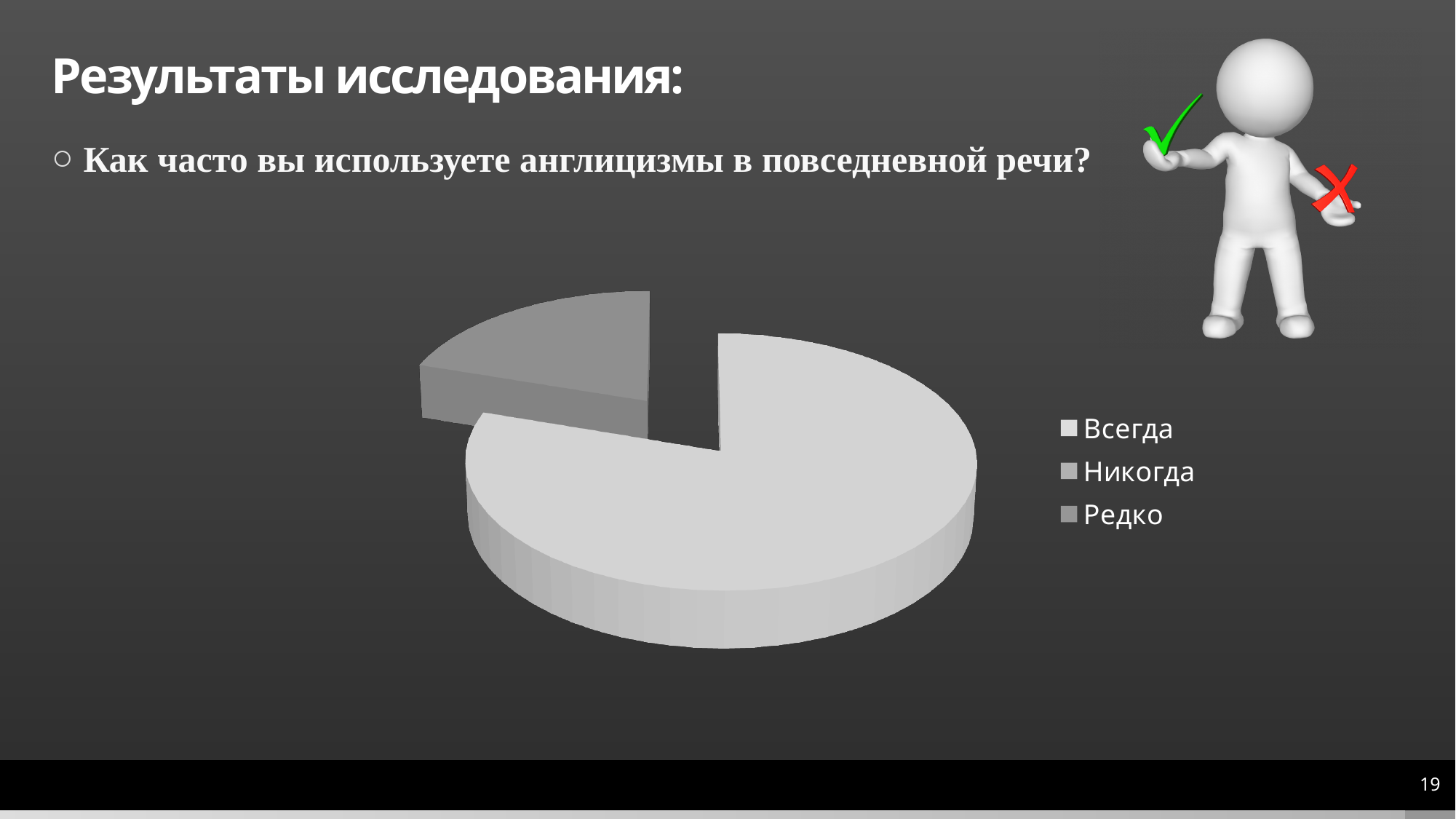
Which slice is larger, Всегда or Редко? Всегда Does the Всегда slice take up more or less than half of the pie? more Which category has the largest slice of the pie? Всегда What are the three legend entries of the chart? Всегда, Никогда, Редко How many entries does the chart legend list? 3 What kind of chart is shown on the slide? pie chart Which category is shown as the exploded (pulled-out) slice of the pie? Редко